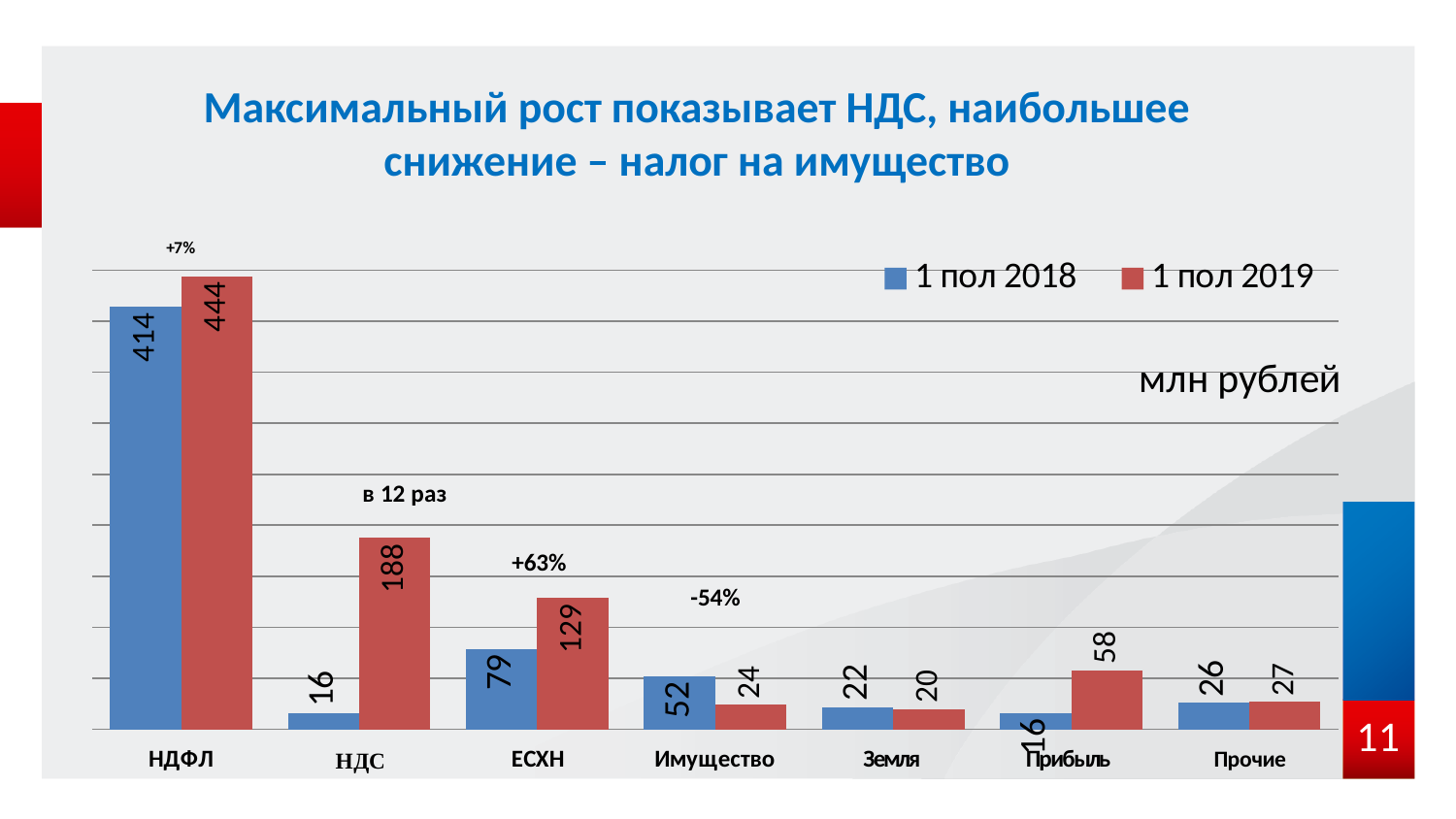
Which is larger for Имущество: the 1 пол 2018 value or the 1 пол 2019 value? 1 пол 2018 How many series does the legend list? 2 What percentage change label is shown above the ЕСХН bars? +63% What is the value for ЕСХН in the 1 пол 2019 series? 129 What is the value for Имущество in the 1 пол 2018 series? 52 What is the value for НДФЛ in the 1 пол 2019 series? 444 What is the difference between the 1 пол 2019 and 1 пол 2018 values for НДС? 172 How many categories are shown on the x axis? 7 What is the value for НДС in the 1 пол 2018 series? 16 What kind of chart is shown on the slide? bar chart Which category has the lowest value in the 1 пол 2019 series? Земля Which category has the highest value in the 1 пол 2019 series? НДФЛ